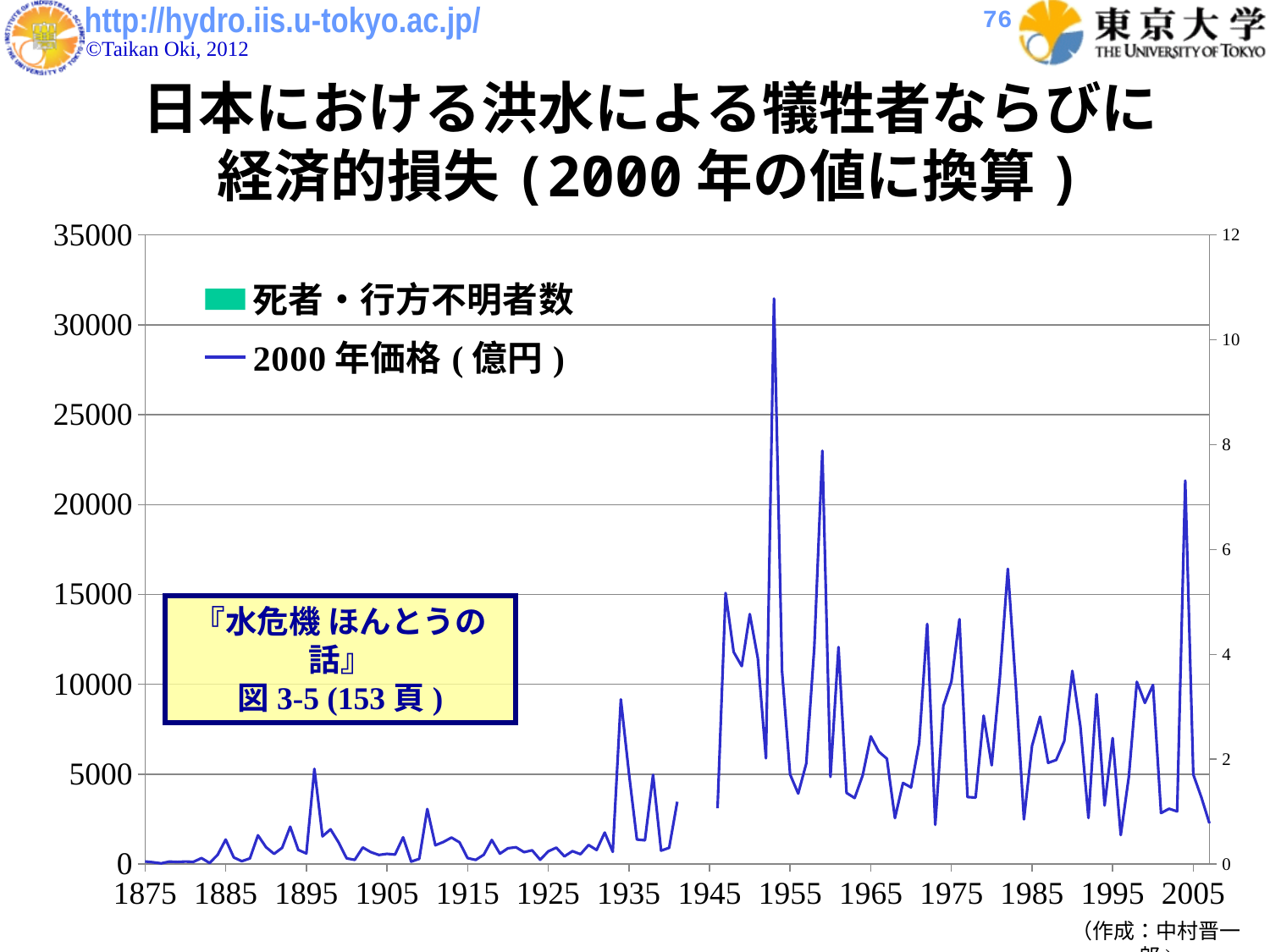
Is the value of the 2000年価格 line at 1915 greater or less than 5000? less Is the highest peak of the 2000年価格 line, which occurs between 1945 and 1955, greater or less than 25000? greater Which is larger: the peak of the 2000年価格 line between 1945 and 1955, or the peak just before 1960? the peak between 1945 and 1955 What is the label of the second legend entry, shown with a blue line? 2000年価格(億円) What kind of chart is shown on the slide? line chart Is the value of the 2000年価格 line at 1875 greater or less than 5000? less What is the highest value shown on the left vertical axis? 35000 How many series does the legend list? 2 What is the first year label shown on the horizontal axis? 1875